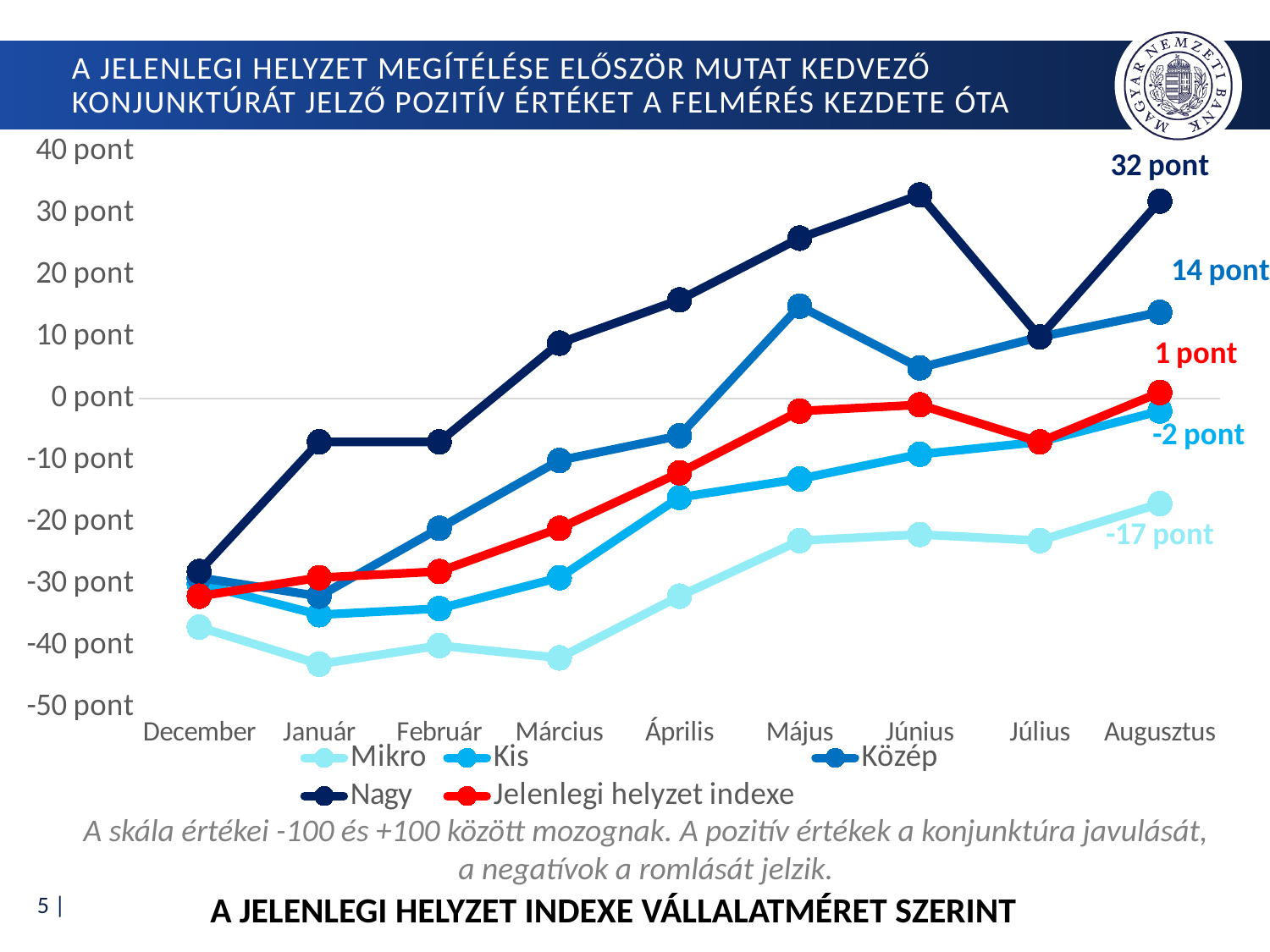
Which series has the highest value in Augusztus? Nagy What is the value for Mikro in Augusztus? -17 pont What is the value for Jelenlegi helyzet indexe in Augusztus? 1 pont What is the value for Nagy in Augusztus? 32 pont How many months are shown on the x axis? 9 Which series has the lowest value in Augusztus? Mikro How many series does the legend list? 5 Is the value for Nagy in Június greater or less than 30 pont? greater What is the difference between the Nagy and Közép values in Augusztus? 18 pont What type of chart is shown on the slide? line chart Does the Mikro series generally rise or fall from December to Augusztus? rise What is the value for Közép in Augusztus? 14 pont